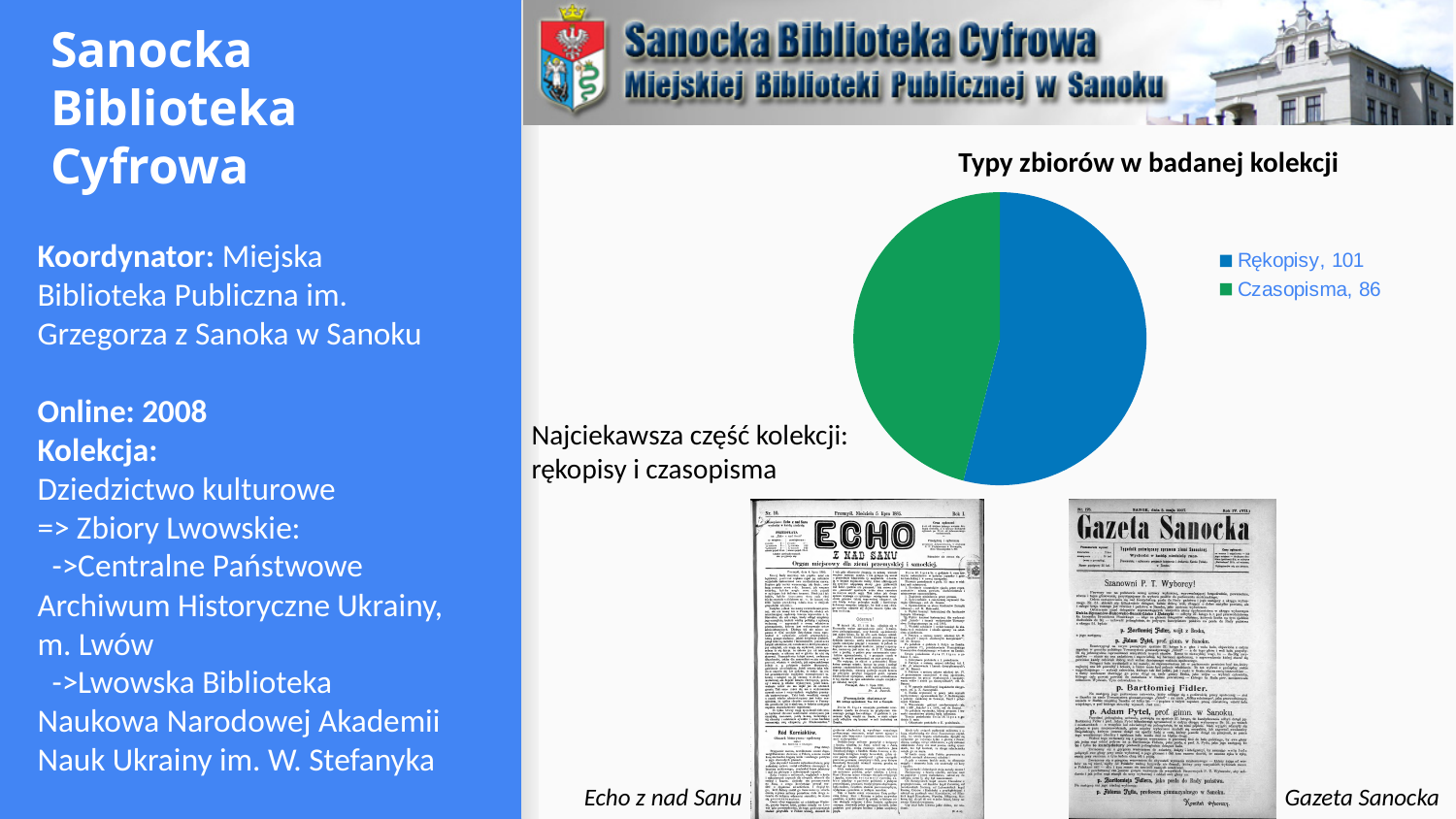
What is the value for Czasopisma in the chart? 86 Which category has the largest slice in the pie chart? Rękopisy How many categories does the pie chart show? 2 What is the value for Rękopisy in the chart? 101 What is the total of the two values shown in the pie chart? 187 How many entries does the chart legend list? 2 Which is larger, the value for Rękopisy or the value for Czasopisma? Rękopisy What is the title of the chart? Typy zbiorów w badanej kolekcji What type of chart is shown on the slide? Pie chart Which category has the smallest slice in the pie chart? Czasopisma What is the difference between the values for Rękopisy and Czasopisma? 15 Which colour represents Czasopisma in the pie chart? Green